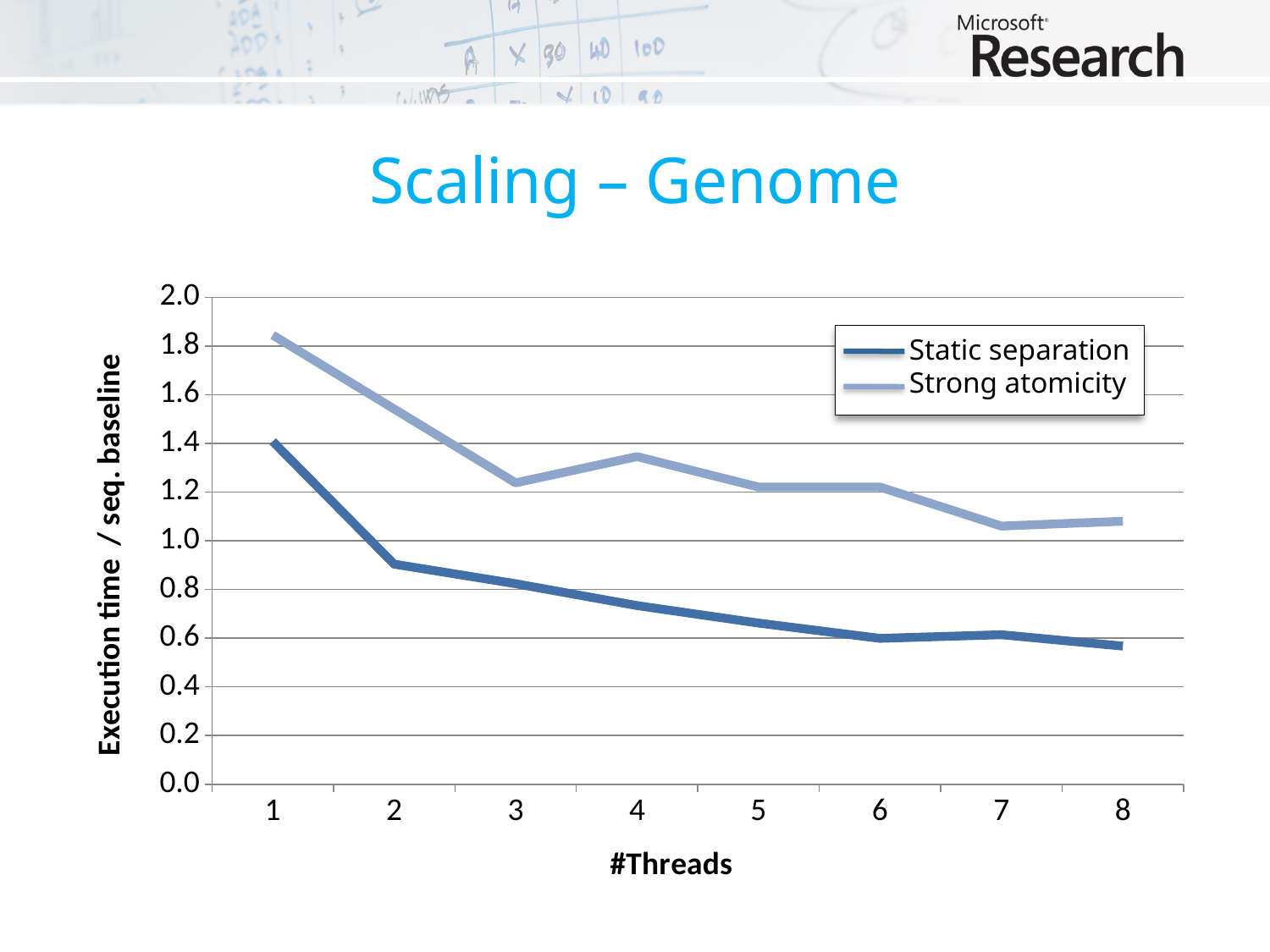
What is the label of the y axis? Execution time / seq. baseline How many series does the legend list? 2 At which thread count is the Static separation series highest? 1 Do the values for Strong atomicity generally rise or fall as the number of threads increases? fall Is the value for Strong atomicity at 7 threads greater or less than 1.0? greater What kind of chart is shown on the slide? line chart Is the value for Static separation at 8 threads greater or less than 0.6? less What is the title of the chart? Scaling – Genome Which series has the higher value at 4 threads, Static separation or Strong atomicity? Strong atomicity Is the value for Strong atomicity at 1 thread greater or less than 1.8? greater How many thread counts are plotted along the x axis? 8